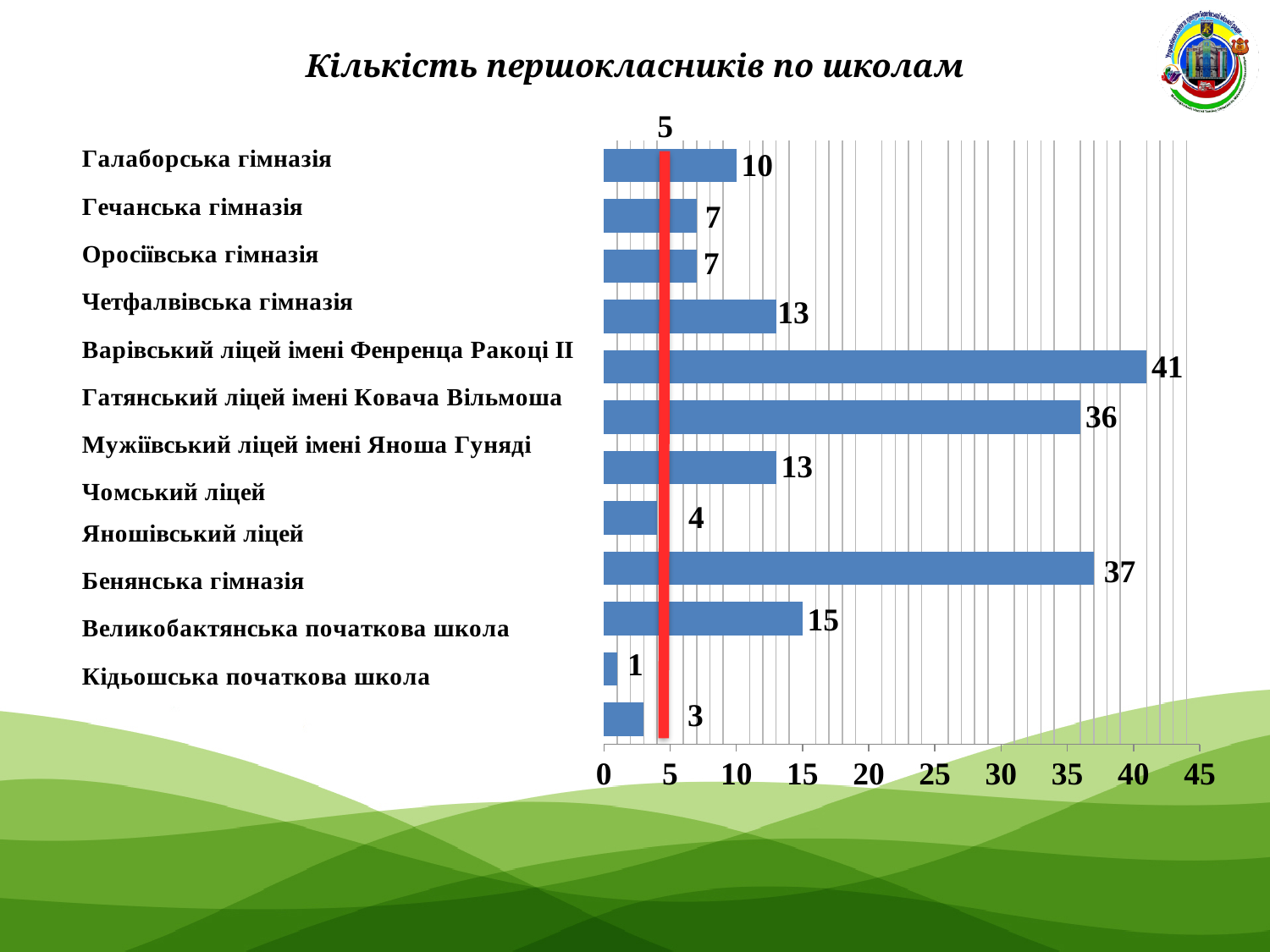
At what value is the red vertical line drawn on the chart? 5 What is the value for Гатянський ліцей імені Ковача Вільмоша? 36 What is the difference between the values for Варівський ліцей імені Фенренца Ракоці II and Гатянський ліцей імені Ковача Вільмоша? 5 Which school has the lowest number of first-graders? Великобактянська початкова школа What kind of chart is shown on the slide? bar chart What is the value for Галаборська гімназія? 10 What is the value for Кідьошська початкова школа? 3 What is the title of the chart? Кількість першокласників по школам How many schools (bars) are shown in the chart? 12 Which school has the highest number of first-graders? Варівський ліцей імені Фенренца Ракоці II Which has a larger value, Галаборська гімназія or Четфалвівська гімназія? Четфалвівська гімназія What is the value for Варівський ліцей імені Фенренца Ракоці II? 41